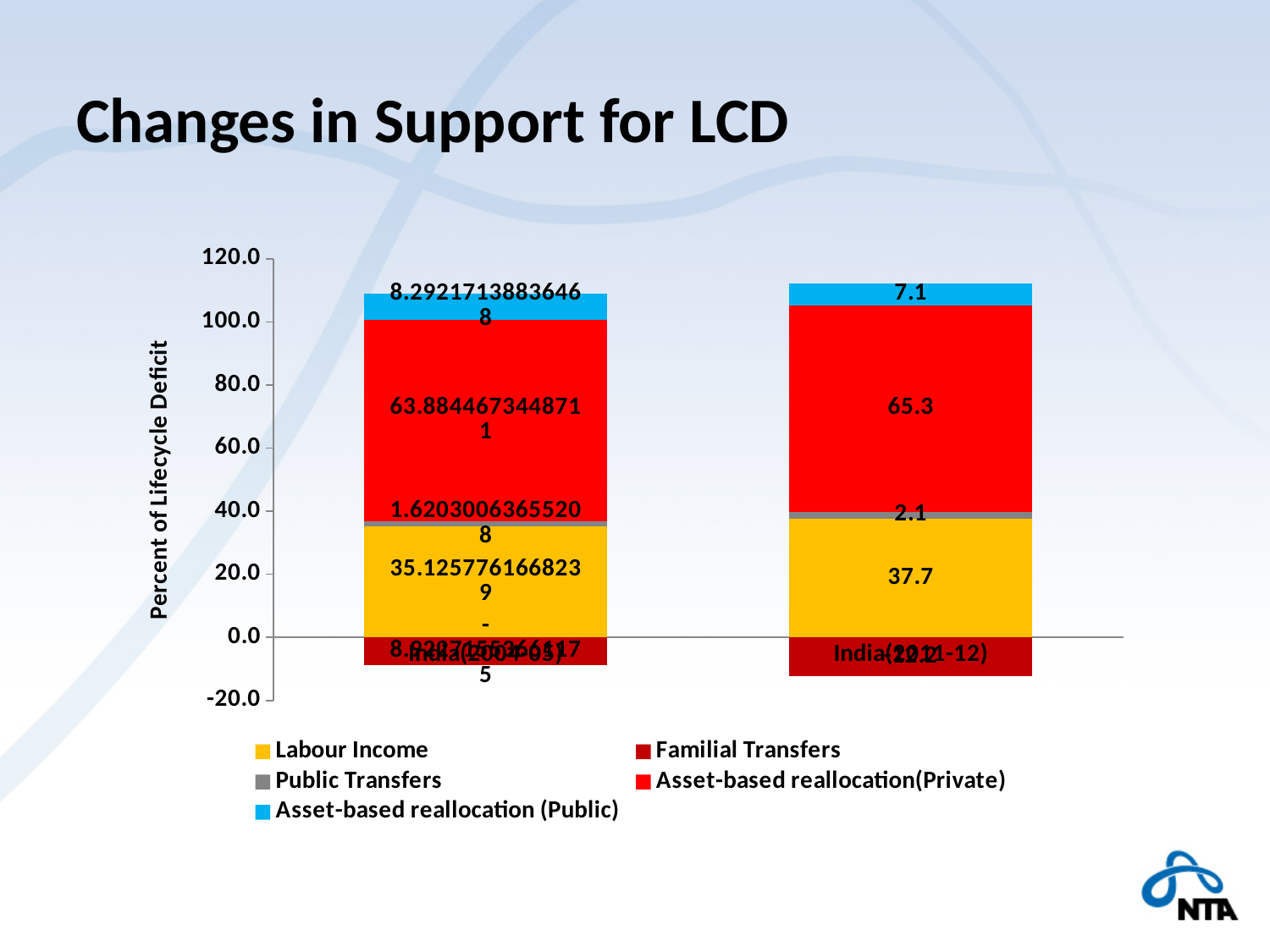
How many series does the legend list? 5 What is the value of Asset-based reallocation (Public) for India(2011-12)? 7.1 What is the value of Public Transfers for India(2011-12)? 2.1 Is the top of the India(2004-05) stacked bar greater or less than 100.0? greater What is the title of the y axis? Percent of Lifecycle Deficit Is Labour Income larger for India(2004-05) or India(2011-12)? India(2011-12) How many categories (bars) are shown on the x axis? 2 What kind of chart is shown on the slide? Stacked bar chart What is the value of Asset-based reallocation(Private) for India(2011-12)? 65.3 Which series has the largest value in the India(2011-12) bar? Asset-based reallocation(Private) What is the value of Labour Income for India(2011-12)? 37.7 What is the difference between Asset-based reallocation(Private) and Labour Income for India(2011-12)? 27.6